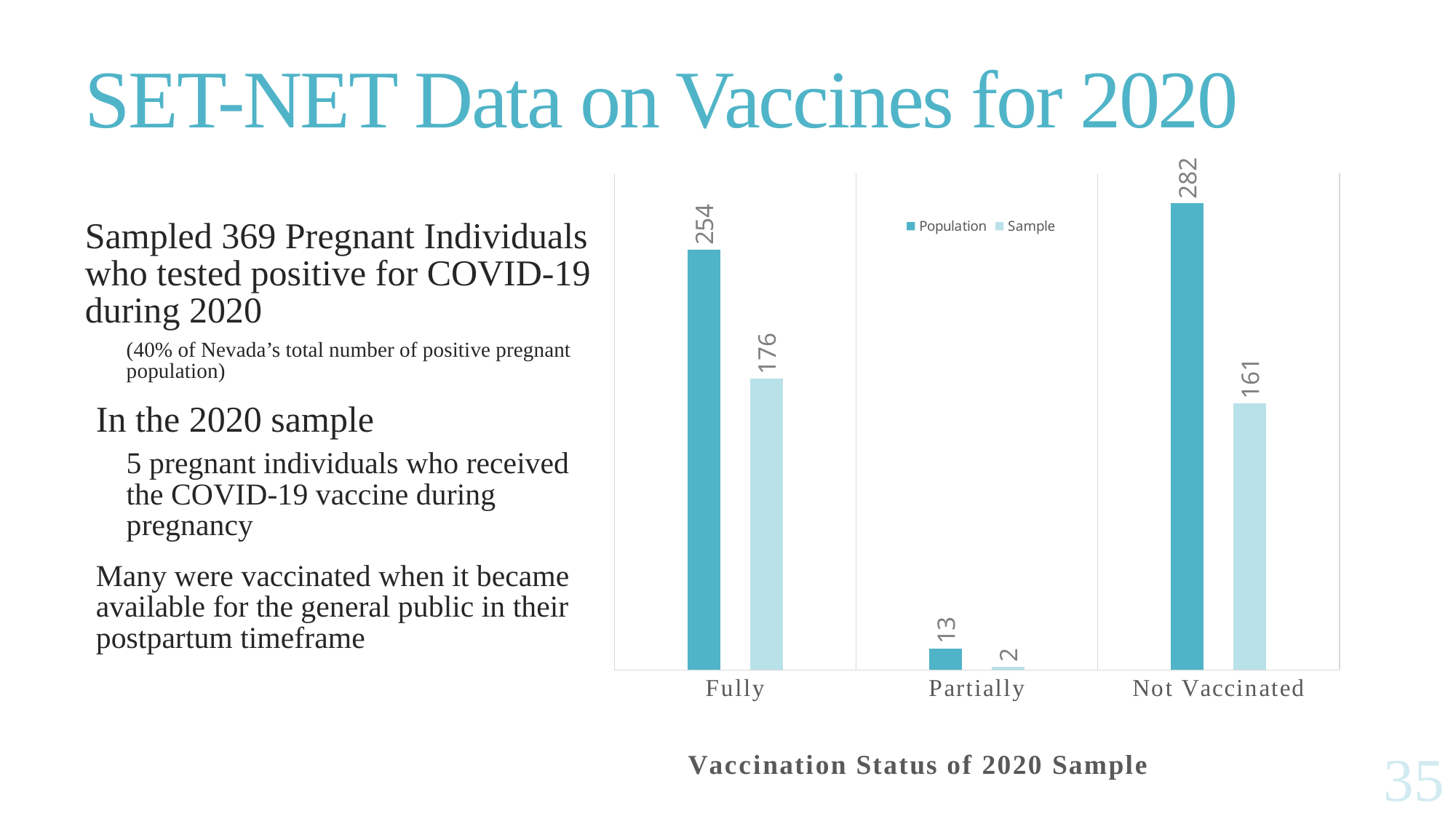
What is the Population value for the Fully vaccinated category? 254 What is the title of the chart? Vaccination Status of 2020 Sample How many categories are shown on the x axis? 3 What kind of chart is shown on the slide? Bar chart What is the difference between the Population values for Not Vaccinated and Fully? 28 What is the Sample value for the Partially vaccinated category? 2 What is the Sample value for the Not Vaccinated category? 161 Which category has the highest Population value? Not Vaccinated How many series does the legend list? 2 Which category has the lowest Sample value? Partially What is the difference between the Population and Sample values for the Fully vaccinated category? 78 Which is larger, the Population value for Partially or the Sample value for Fully? Sample value for Fully